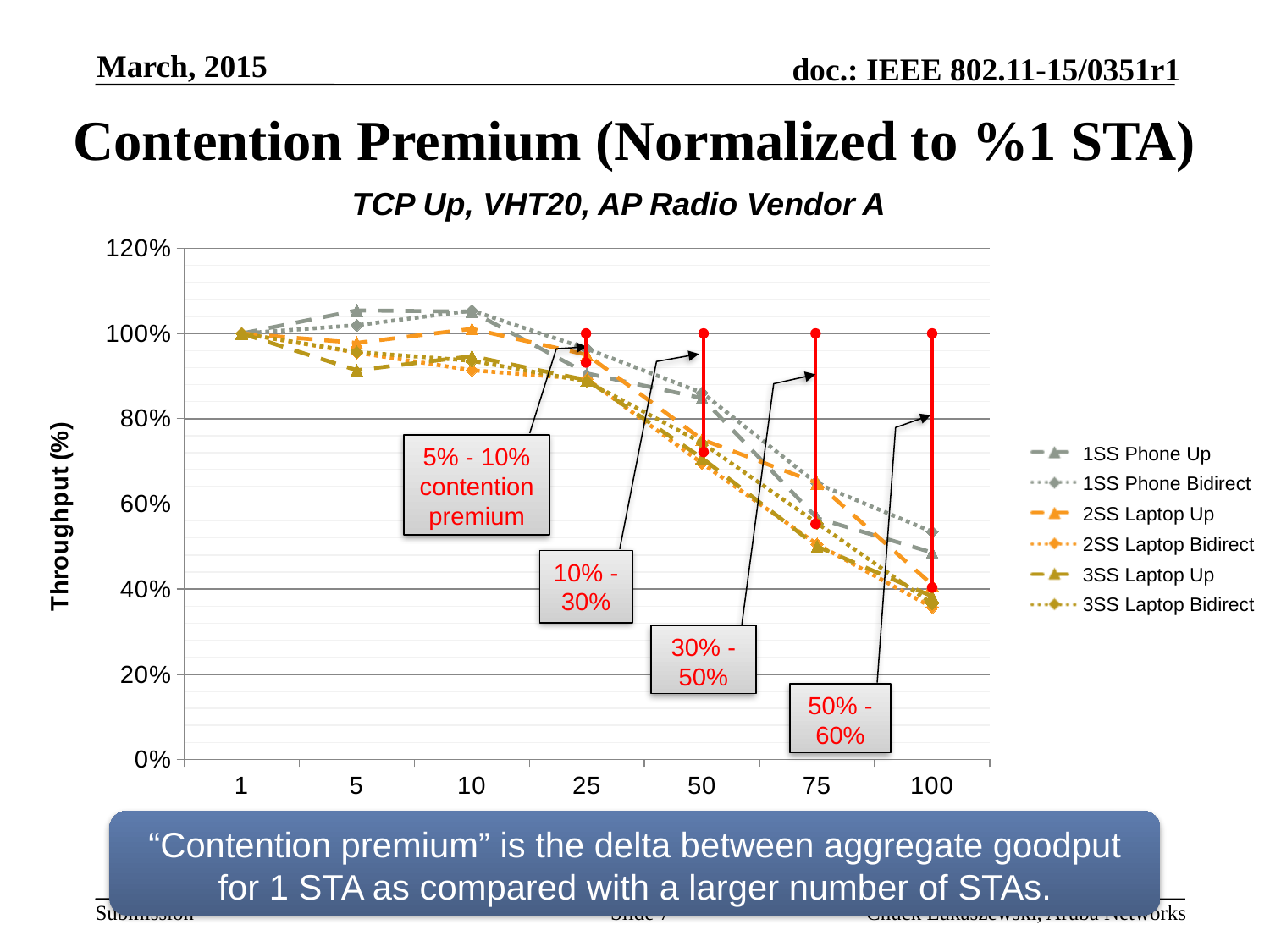
Is the value for 1SS Phone Bidirect at x = 100 greater or less than 40%? greater Which series has the highest value at x = 100? 1SS Phone Bidirect What is the label on the y axis? Throughput (%) What kind of chart is shown on the slide? line chart Is the value for 3SS Laptop Up at x = 100 greater or less than 60%? less Is the value for 1SS Phone Up at x = 5 greater or less than 100%? greater How many series does the legend list? 6 Do the values generally rise or fall as the number of STAs increases along the x axis? fall How many categories are shown on the x axis? 7 At x = 50, which is larger: 1SS Phone Bidirect or 3SS Laptop Up? 1SS Phone Bidirect What is the value for 1SS Phone Up at x = 1? 100%